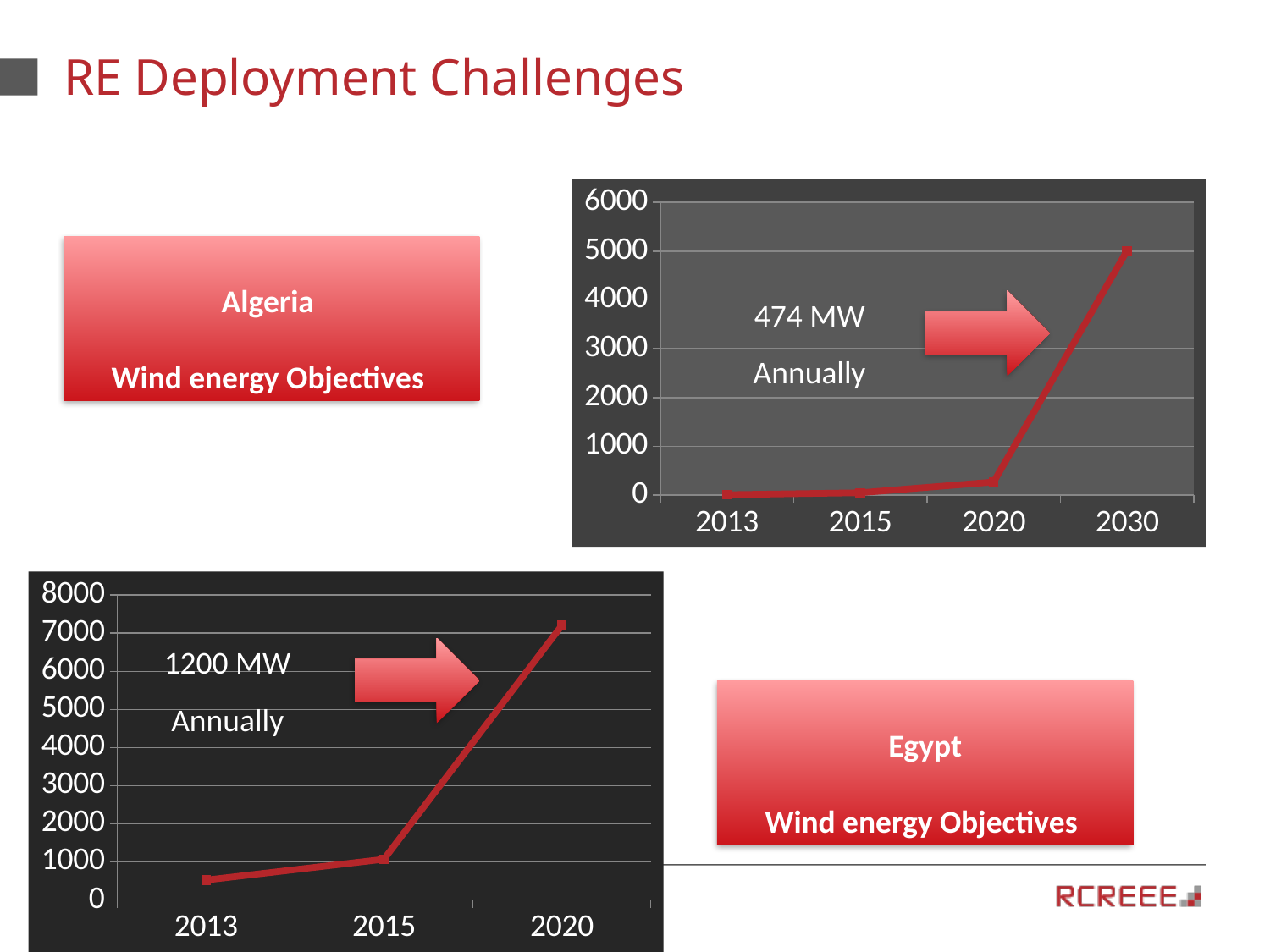
How many years are shown on the x axis of the bottom-left chart? 3 Do the values in the bottom-left chart rise or fall from 2013 to 2020? rise In the top-right chart, is the value for 2020 greater or less than 1000? less In the top-right chart, which year has the highest value? 2030 What kind of chart is the top-right chart on the slide? line chart In the bottom-left chart, which year has the highest value? 2020 In the bottom-left chart, is the value for 2020 greater or less than 7000? greater In the top-right chart, is the value for 2030 greater or less than 4000? greater How many years are shown on the x axis of the top-right chart? 4 In the bottom-left chart, which year has the lowest value? 2013 What kind of chart is the bottom-left chart on the slide? line chart